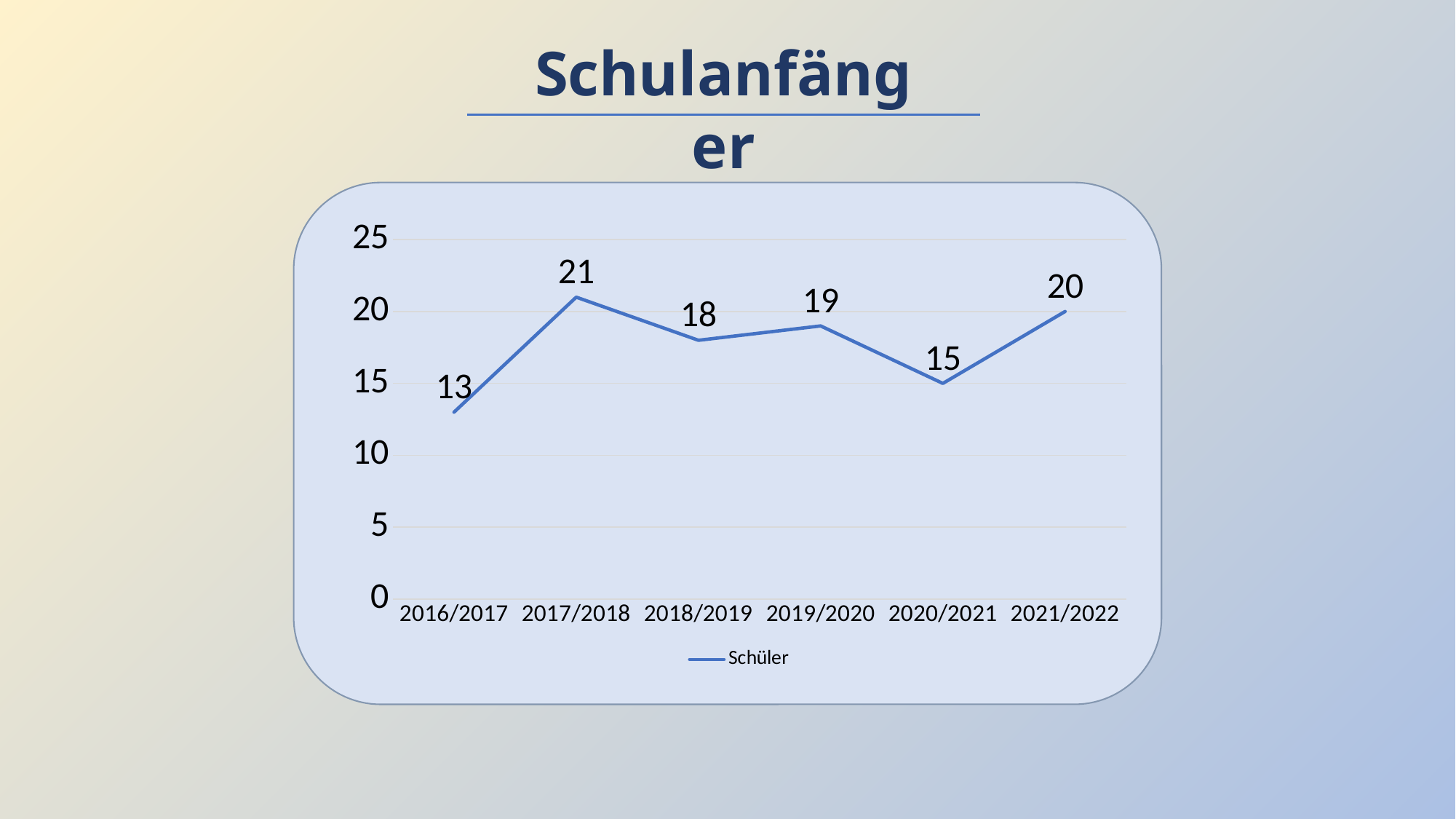
What is the value for 2016/2017? 13 How many school years are plotted on the x axis? 6 What is the name of the series shown in the legend? Schüler Which school year has the lowest value? 2016/2017 What is the value for 2019/2020? 19 Is the value for 2020/2021 greater or less than 20? less Which is larger, the value for 2018/2019 or the value for 2019/2020? 2019/2020 What is the difference between the values for 2017/2018 and 2020/2021? 6 What is the value for 2021/2022? 20 What type of chart is shown on the slide? line chart How many series does the legend list? 1 Which school year has the highest value? 2017/2018